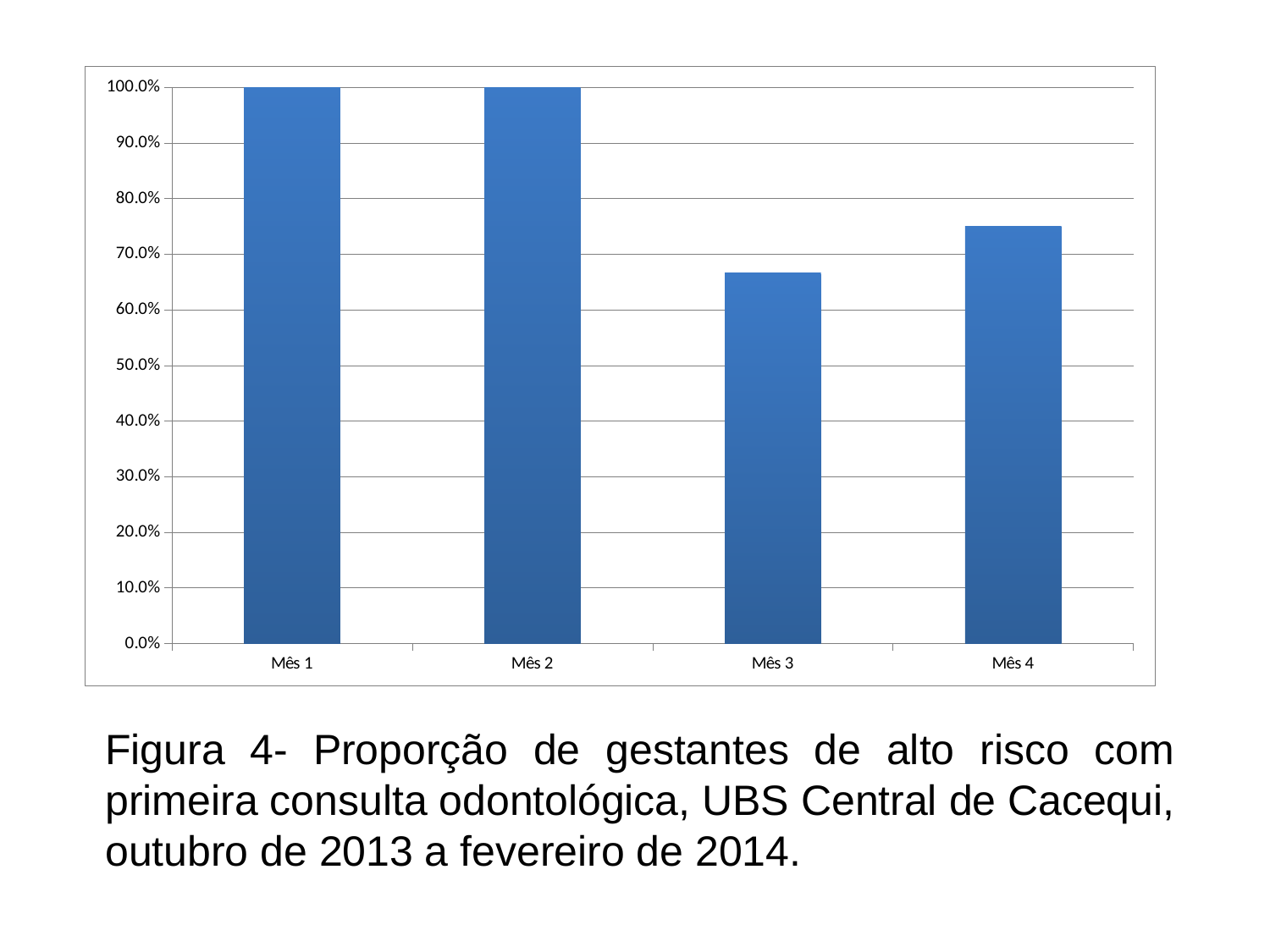
Does the value rise or fall from Mês 2 to Mês 3? fall Is the value for Mês 3 greater or less than 60.0%? greater Is the value for Mês 4 greater or less than 70.0%? greater What is the value for Mês 2? 100.0% Which is larger, the value for Mês 3 or the value for Mês 4? Mês 4 Is the value for Mês 3 greater or less than 70.0%? less How many categories (months) are plotted on the chart? 4 According to the caption below the chart, which figure number is this chart? Figura 4 What is the value for Mês 1? 100.0% Which month has the lowest value? Mês 3 What kind of chart is shown on the slide? bar chart